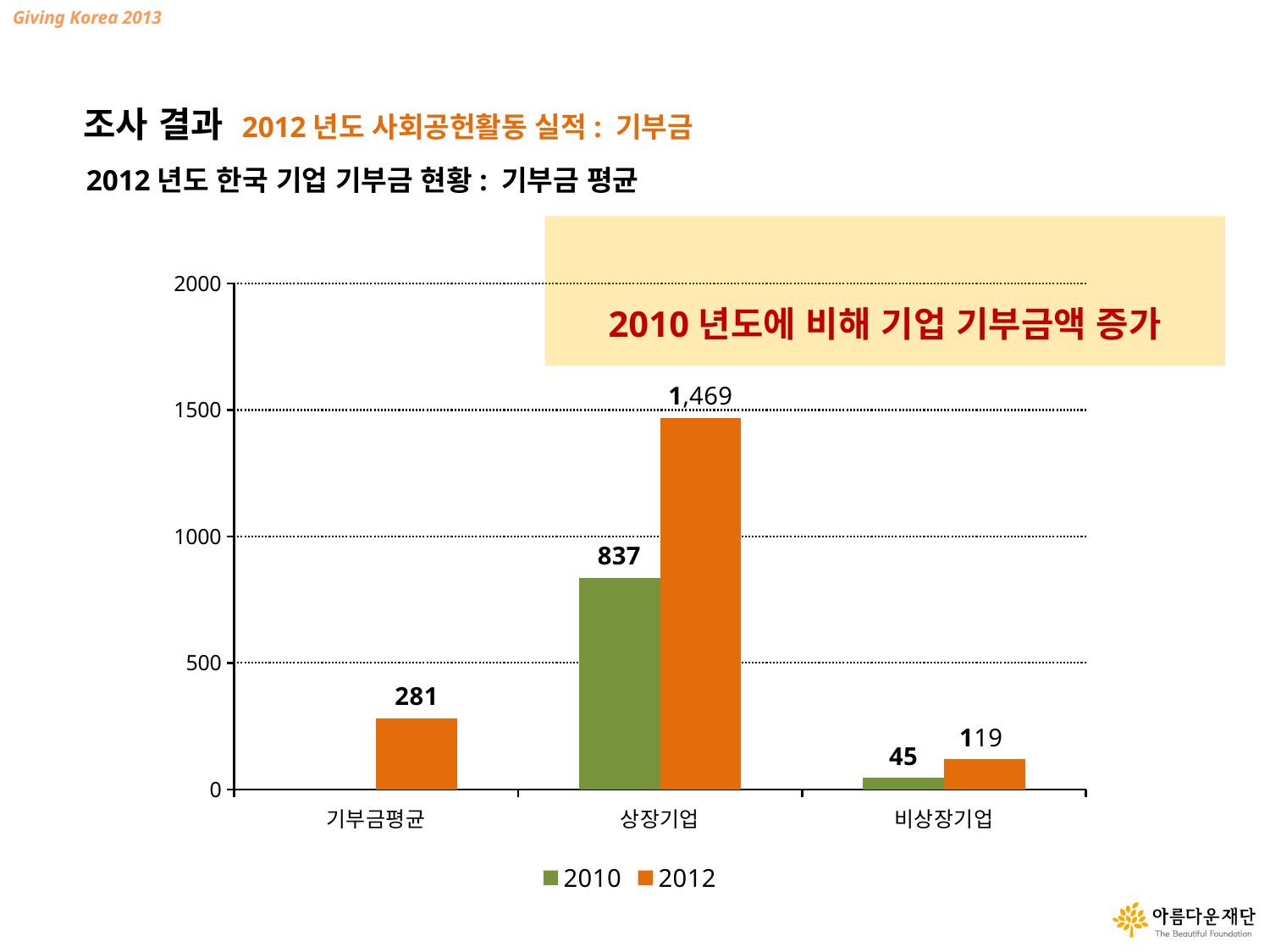
What is the difference between the 2012 and 2010 values for 상장기업? 632 What is the difference between the 2012 and 2010 values for 비상장기업? 74 What is the 2010 value for 상장기업? 837 What is the 2012 value for 비상장기업? 119 What kind of chart is shown on the slide? Bar chart Which is larger for 상장기업, the 2010 value or the 2012 value? 2012 What is the 2012 value for 기부금평균? 281 Which category has the highest 2012 value? 상장기업 What is the 2012 value for 상장기업? 1,469 What is the 2010 value for 비상장기업? 45 Which category has the lowest 2012 value? 비상장기업 How many series does the legend list? 2